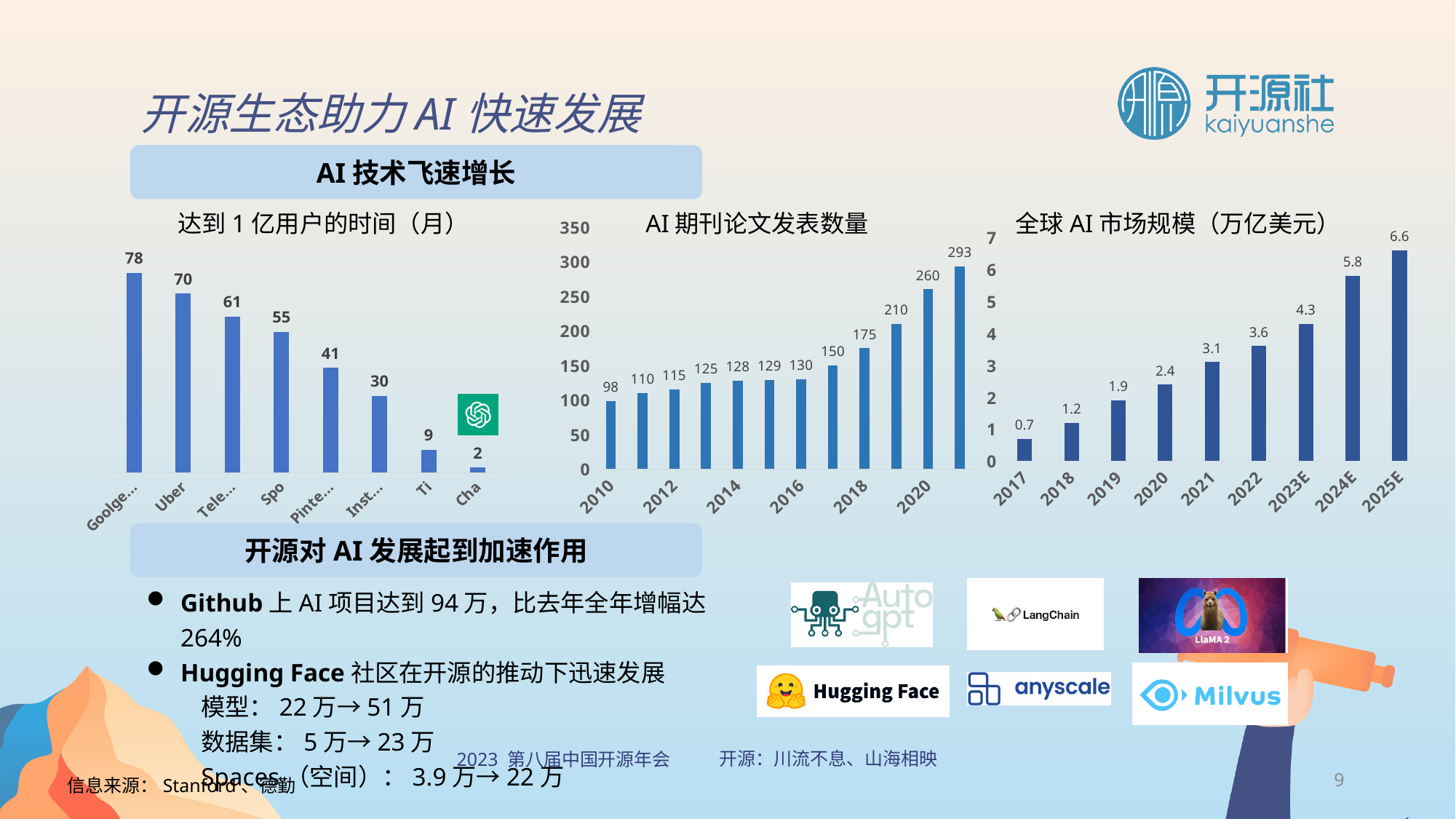
In the chart titled AI 期刊论文发表数量, what is the value for 2010? 98 In the chart titled 达到 1 亿用户的时间（月）, which category has the lowest value? Cha In the chart titled 全球 AI 市场规模（万亿美元）, what is the value for 2021? 3.1 In the chart titled AI 期刊论文发表数量, how many bars are plotted? 12 In the chart titled 全球 AI 市场规模（万亿美元）, what is the difference between the values for 2025E and 2024E? 0.8 In the chart titled AI 期刊论文发表数量, what is the highest value shown? 293 In the chart titled 达到 1 亿用户的时间（月）, what is the difference between the values for Uber and Spo? 15 In the chart titled AI 期刊论文发表数量, do the values rise or fall from left to right? rise In the chart titled 达到 1 亿用户的时间（月）, what is the value for Uber? 70 In the chart titled 达到 1 亿用户的时间（月）, which category has the highest value? Goolge... In the chart titled 达到 1 亿用户的时间（月）, how many categories are shown? 8 What type of chart is the one titled 全球 AI 市场规模（万亿美元）? bar chart